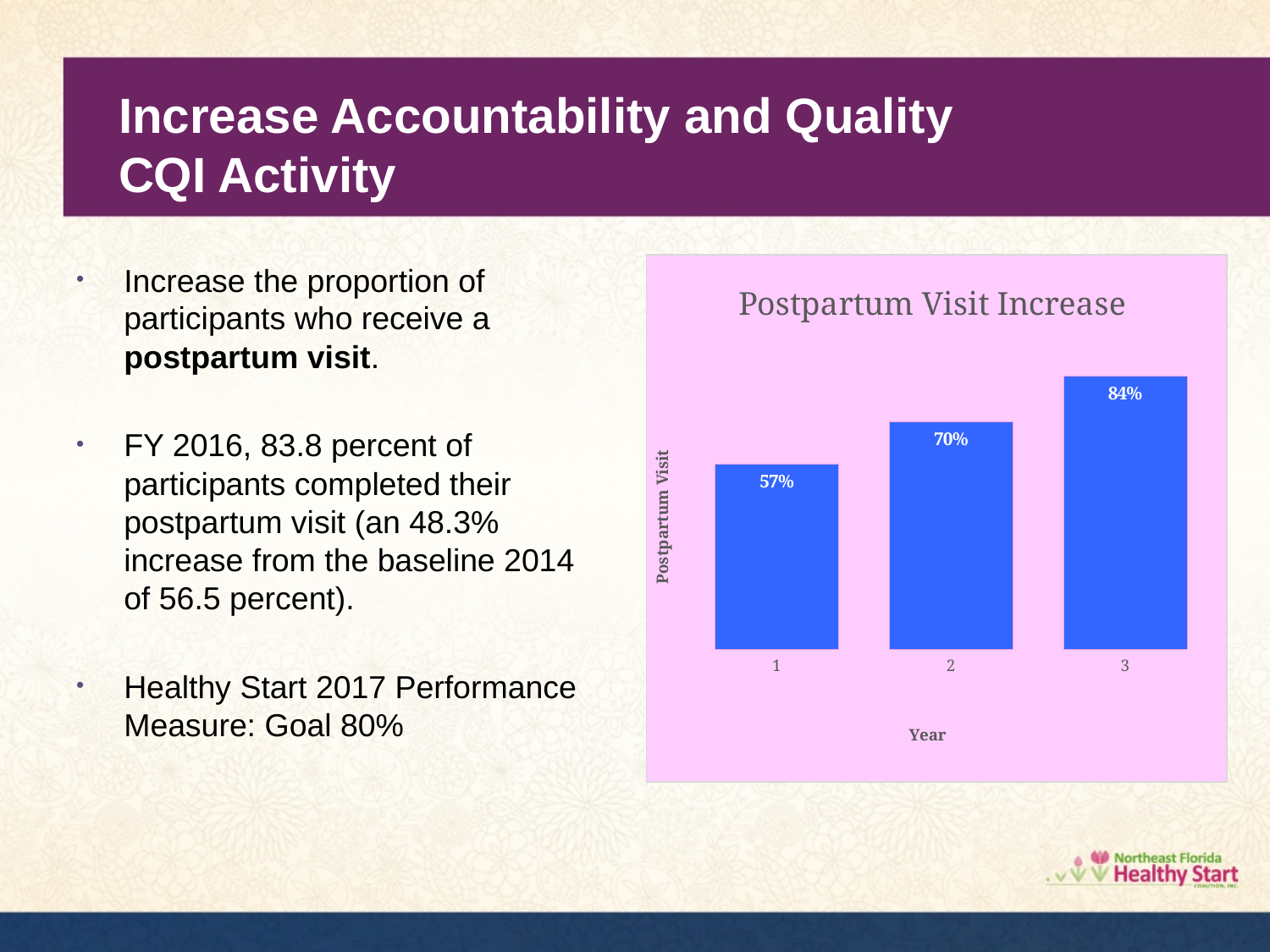
What is the difference between the values for year 3 and year 1? 27% Which is larger, the value for year 2 or the value for year 3? year 3 What kind of chart is shown on the slide? bar chart Do the values rise or fall from year 1 to year 3? rise Which year has the lowest postpartum visit value? 1 Which year has the highest postpartum visit value? 3 What is the difference between the values for year 2 and year 1? 13% What is the value for year 3 in the Postpartum Visit Increase chart? 84% What is the value for year 2 in the Postpartum Visit Increase chart? 70% What is the value for year 1 in the Postpartum Visit Increase chart? 57% What is the title of the chart? Postpartum Visit Increase How many bars are shown in the chart? 3